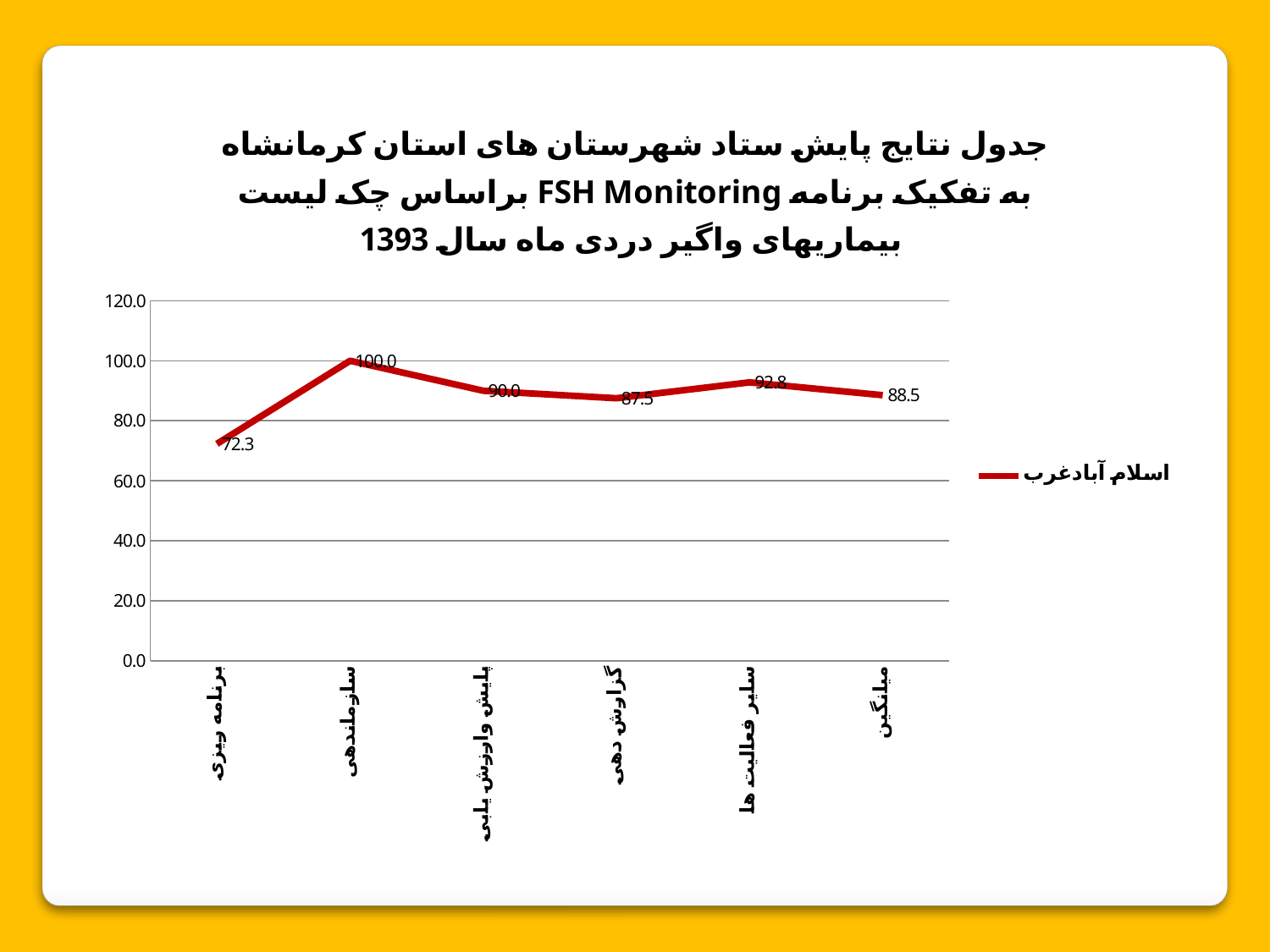
What kind of chart is shown on the slide? line chart Which category has the highest value? سازماندهی How many categories are shown on the x axis? 6 What is the name of the series shown in the legend? اسلام آبادغرب Is the value for برنامه ریزی greater or less than 80.0? less What is the value for سازماندهی? 100.0 What is the value for برنامه ریزی? 72.3 What is the difference between the values for سازماندهی and برنامه ریزی? 27.7 Which is larger, the value for سایر فعالیت ها or the value for پایش و ارزشیابی? سایر فعالیت ها What is the value for گزارش دهی? 87.5 Which category has the lowest value? برنامه ریزی What is the value for میانگین? 88.5